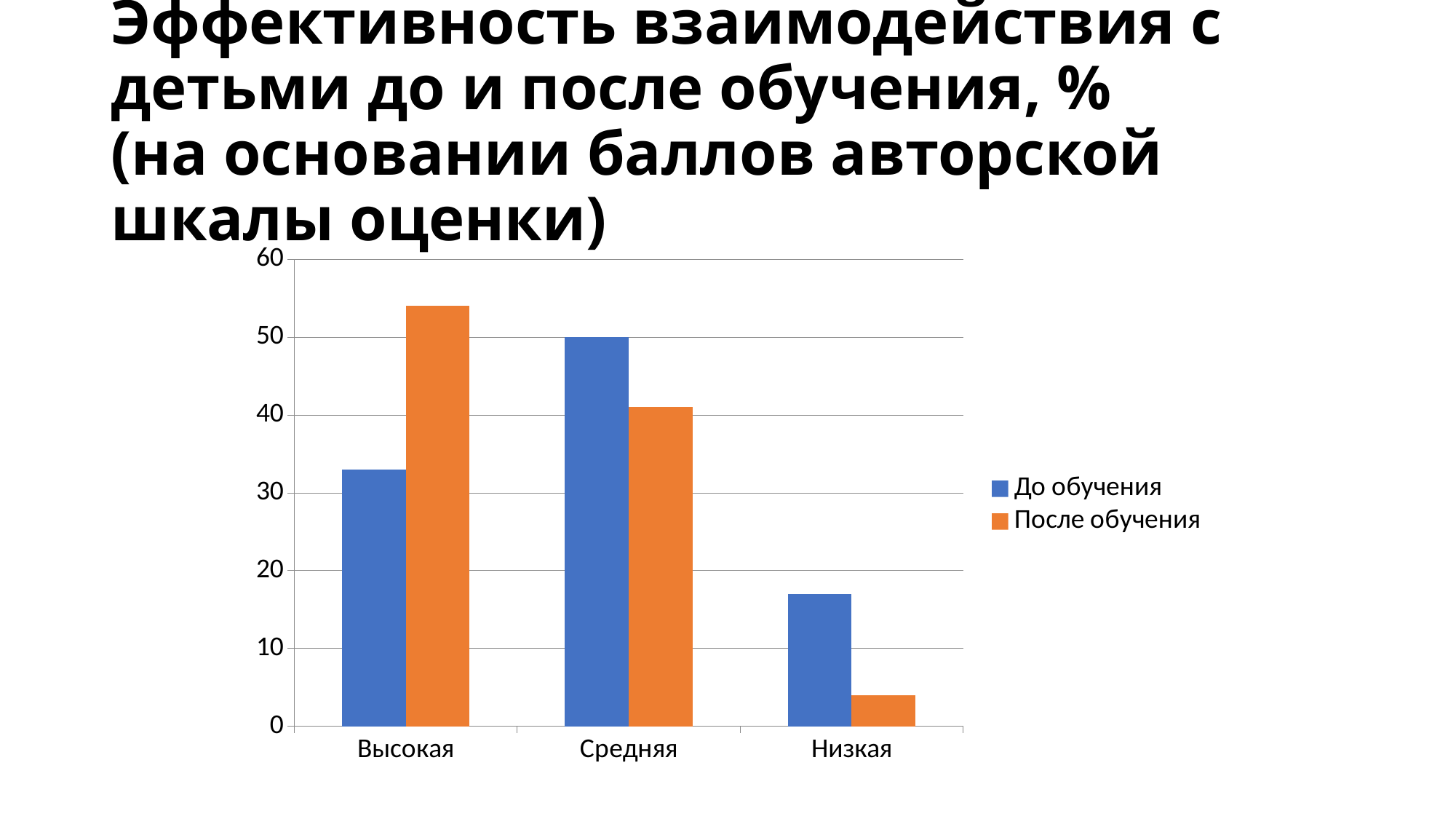
Which legend entry is shown in orange? После обучения What kind of chart is shown on the slide? bar chart Which category has the lowest value for the "До обучения" series? Низкая Is the value for "До обучения" in the "Высокая" category greater or less than 30? greater What is the value for "До обучения" in the "Средняя" category? 50 Which category has the highest value for the "После обучения" series? Высокая Is the value for "После обучения" in the "Низкая" category greater or less than 10? less Is the value for "После обучения" in the "Высокая" category greater or less than 50? greater In the "Средняя" category, which series has the larger value, "До обучения" or "После обучения"? До обучения How many categories are shown on the x axis? 3 How many series does the legend list? 2